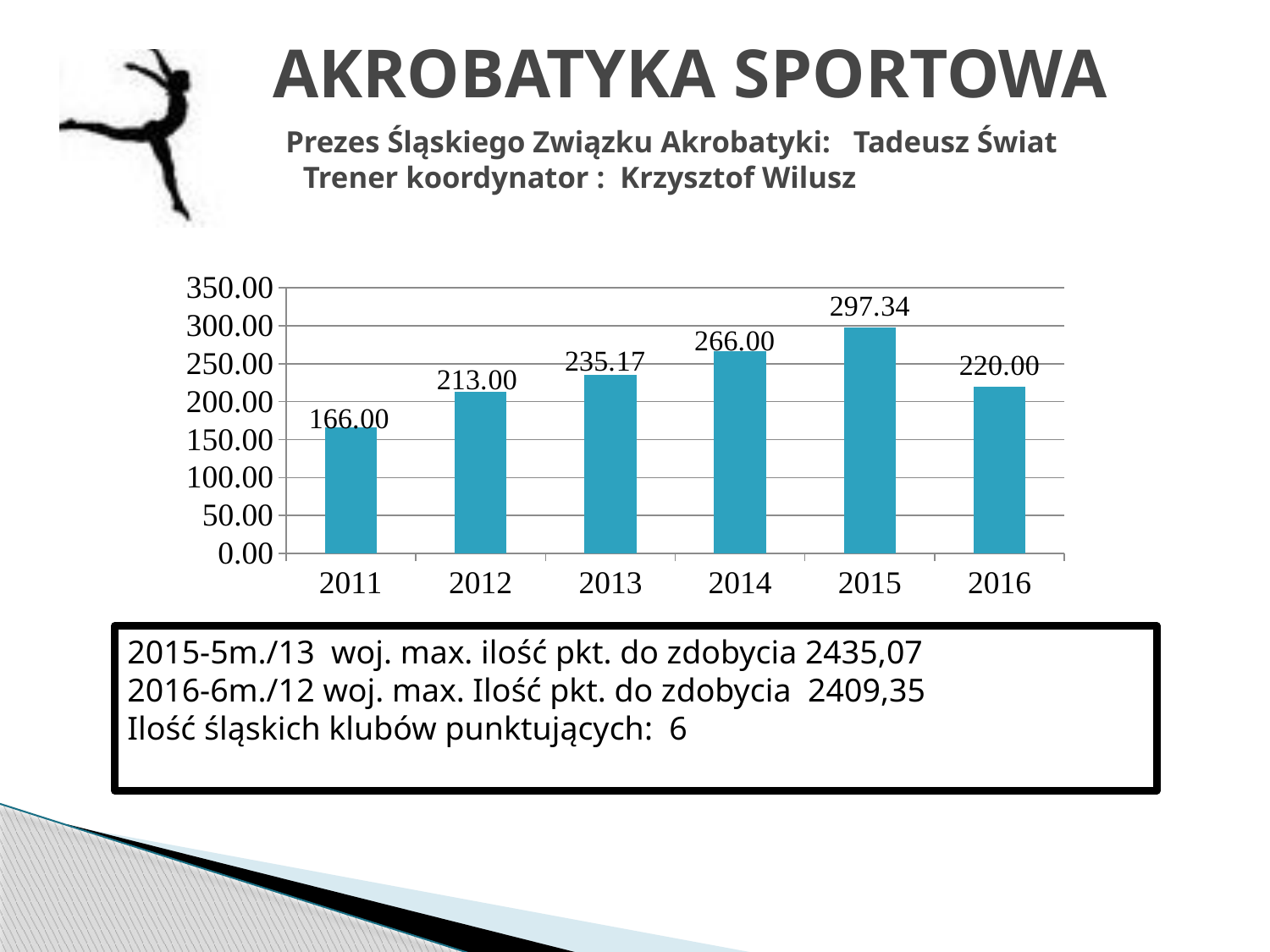
What is the value for 2016? 220.00 What is the value for 2015? 297.34 Do the values rise or fall from 2011 to 2015? rise Which year has the lowest value? 2011 Which year has the highest value? 2015 Which is larger, the value for 2012 or the value for 2016? 2016 What is the difference between the values for 2015 and 2016? 77.34 How many years are shown on the x axis? 6 Is the value for 2013 greater or less than 200.00? greater What kind of chart is shown on the slide? bar chart What is the difference between the values for 2014 and 2013? 30.83 What is the value for 2011? 166.00